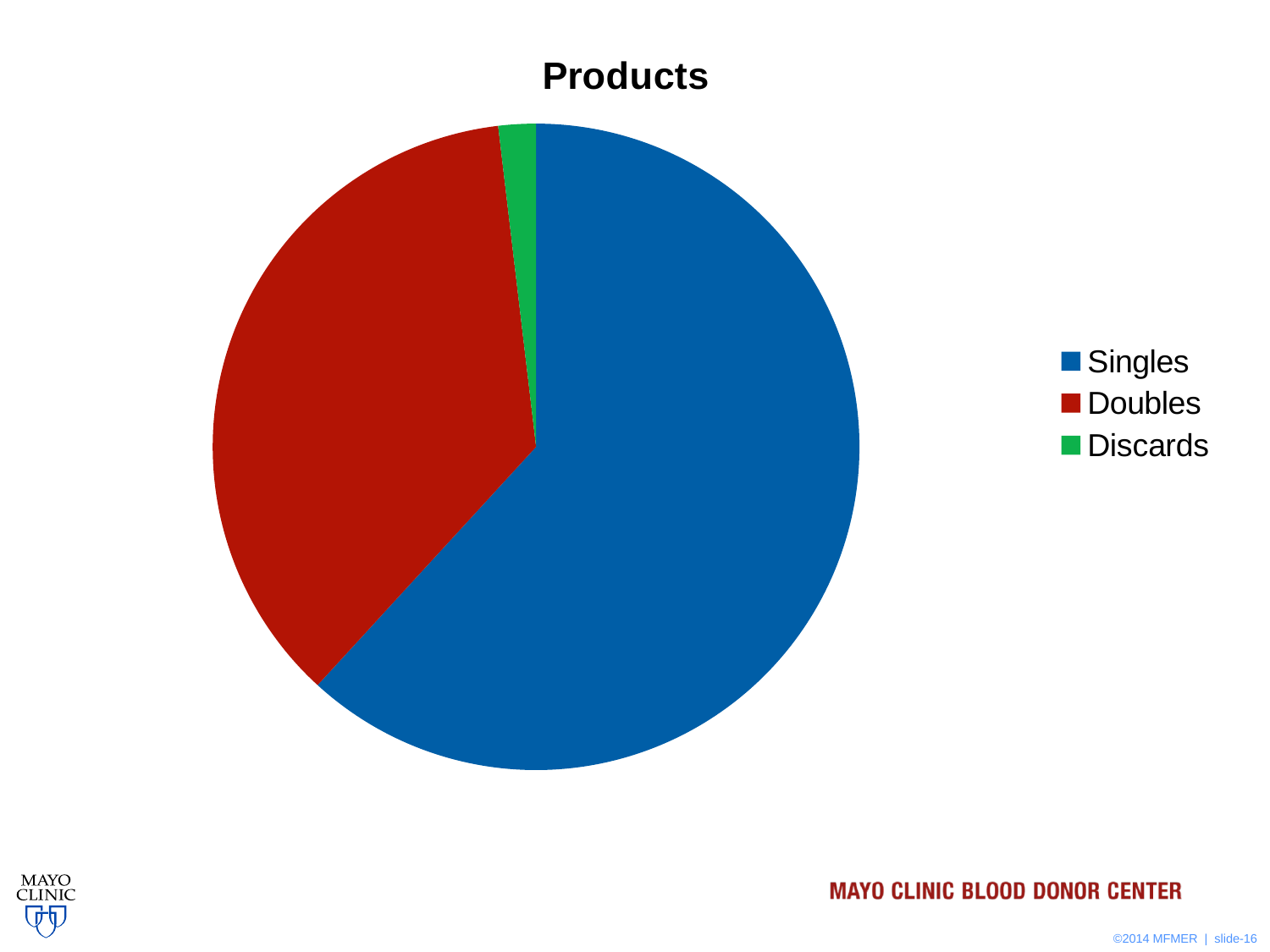
Does the Singles slice take up more or less than half of the pie? more Which slice is larger, Singles or Doubles? Singles Which category has the smallest slice of the pie? Discards How many categories does the legend list? 3 Which slice is larger, Doubles or Discards? Doubles What colour is the Singles slice? blue Which category is shown in green? Discards What kind of chart is shown on the slide? pie chart Which category has the largest slice of the pie? Singles What is the title of the chart? Products